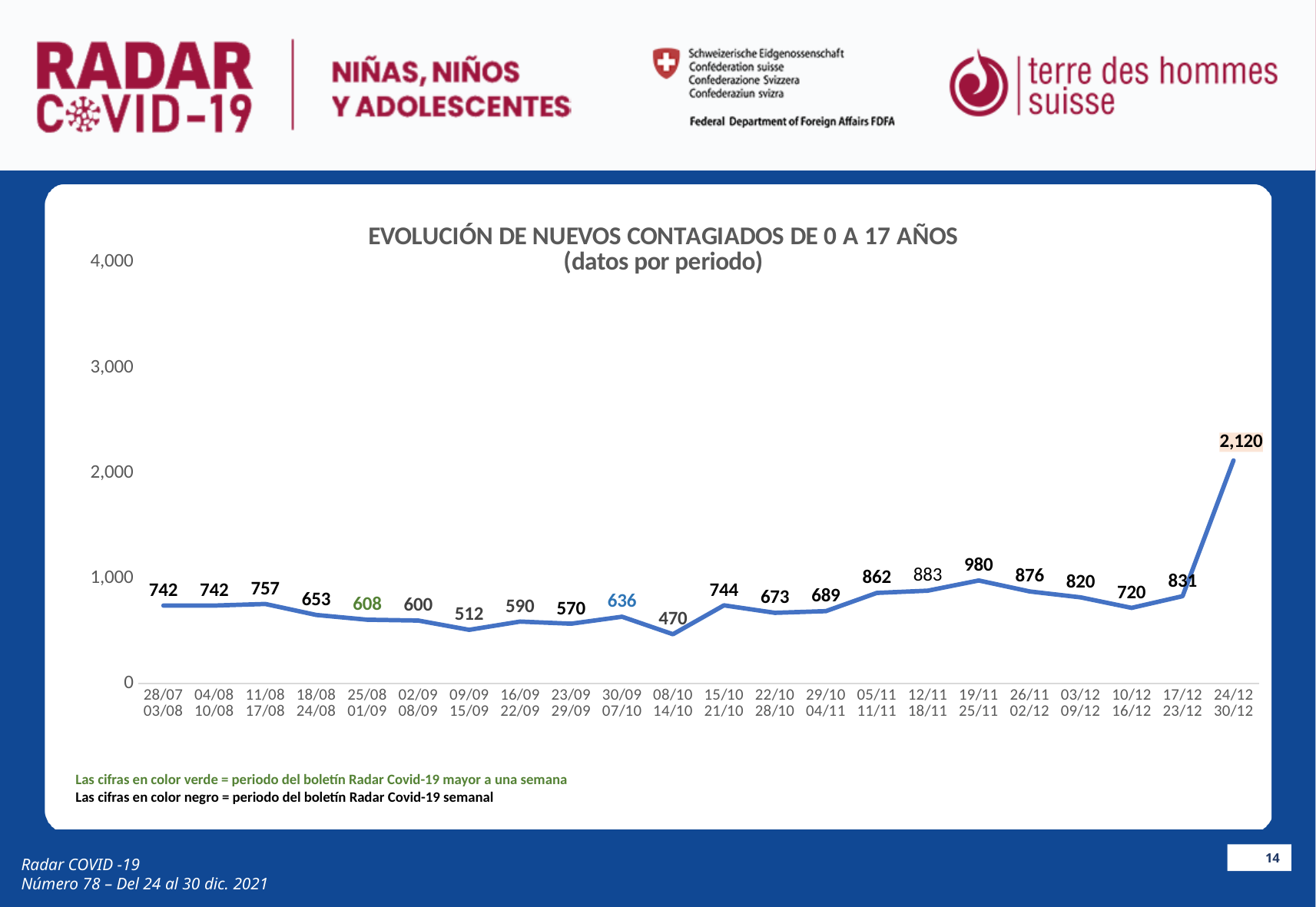
What is the value for the period 25/08–01/09? 608 What is the title of the chart? EVOLUCIÓN DE NUEVOS CONTAGIADOS DE 0 A 17 AÑOS (datos por periodo) Which is larger, the value for 05/11–11/11 or the value for 12/11–18/11? 12/11–18/11 How many periods (data points) are plotted on the chart? 22 What is the value for the period 08/10–14/10? 470 What is the value for the period 19/11–25/11? 980 What is the difference between the values for 24/12–30/12 and 17/12–23/12? 1,289 Which period has the highest value? 24/12–30/12 Is the value for 24/12–30/12 greater or less than 2,000? greater What is the value for the period 24/12–30/12? 2,120 What type of chart is shown on the slide? line chart Which period has the lowest value? 08/10–14/10